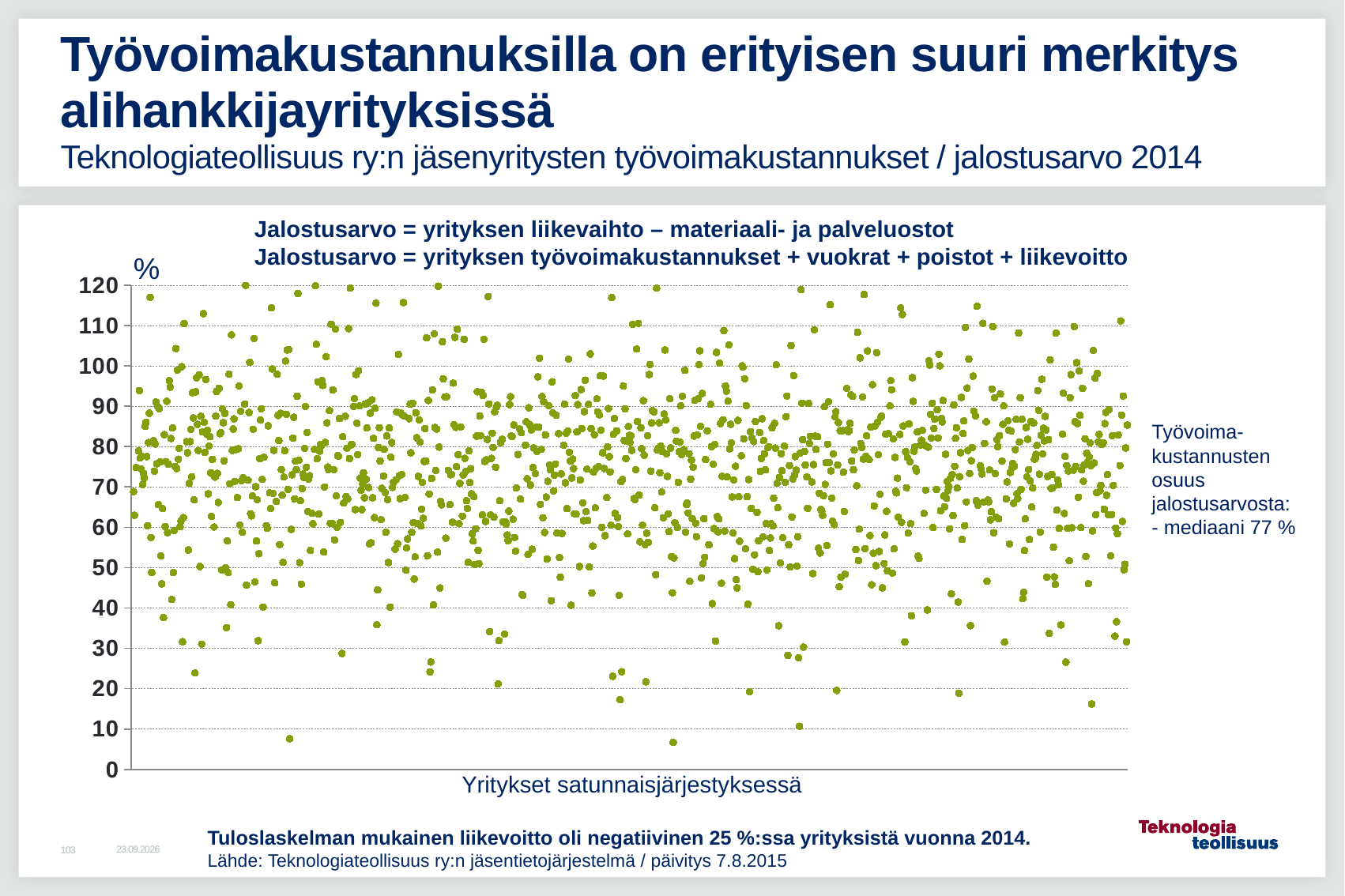
Is the lowest plotted point in the chart greater or less than 10? less What is the median share of labour costs in value added reported next to the chart? 77 % What kind of chart is shown on the slide? scatter chart Is the median value of 77 % stated on the slide greater or less than 80? less What is the highest tick value shown on the y axis? 120 Which year's data does the chart show? 2014 Is the highest plotted point in the chart greater or less than 110? greater What unit is shown on the y axis of the chart? %